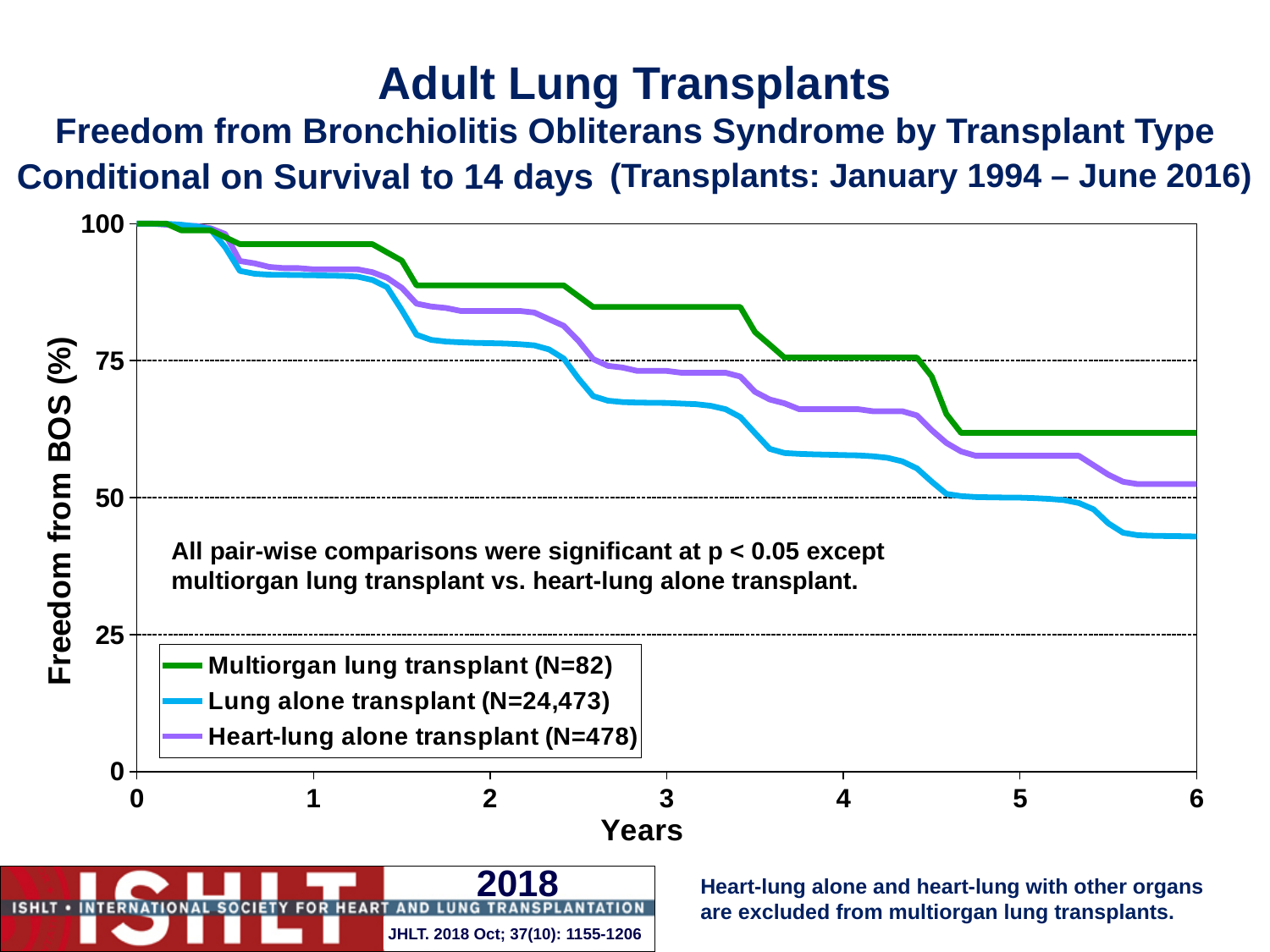
What kind of chart is shown on the slide? line chart Which transplant type has the highest freedom from BOS at 6 years? Multiorgan lung transplant Is the freedom from BOS for lung alone transplant at 3 years greater or less than 75? less How many series does the legend list? 3 Do the freedom from BOS values rise or fall as years increase? fall Is the freedom from BOS for lung alone transplant at 6 years greater or less than 50? less Is the freedom from BOS for multiorgan lung transplant at 6 years greater or less than 50? greater What is the N for the lung alone transplant group shown in the legend? 24,473 Which transplant type has the lowest freedom from BOS at 6 years? Lung alone transplant At 6 years, is freedom from BOS higher for multiorgan lung transplant or lung alone transplant? Multiorgan lung transplant What is the label of the y axis? Freedom from BOS (%)